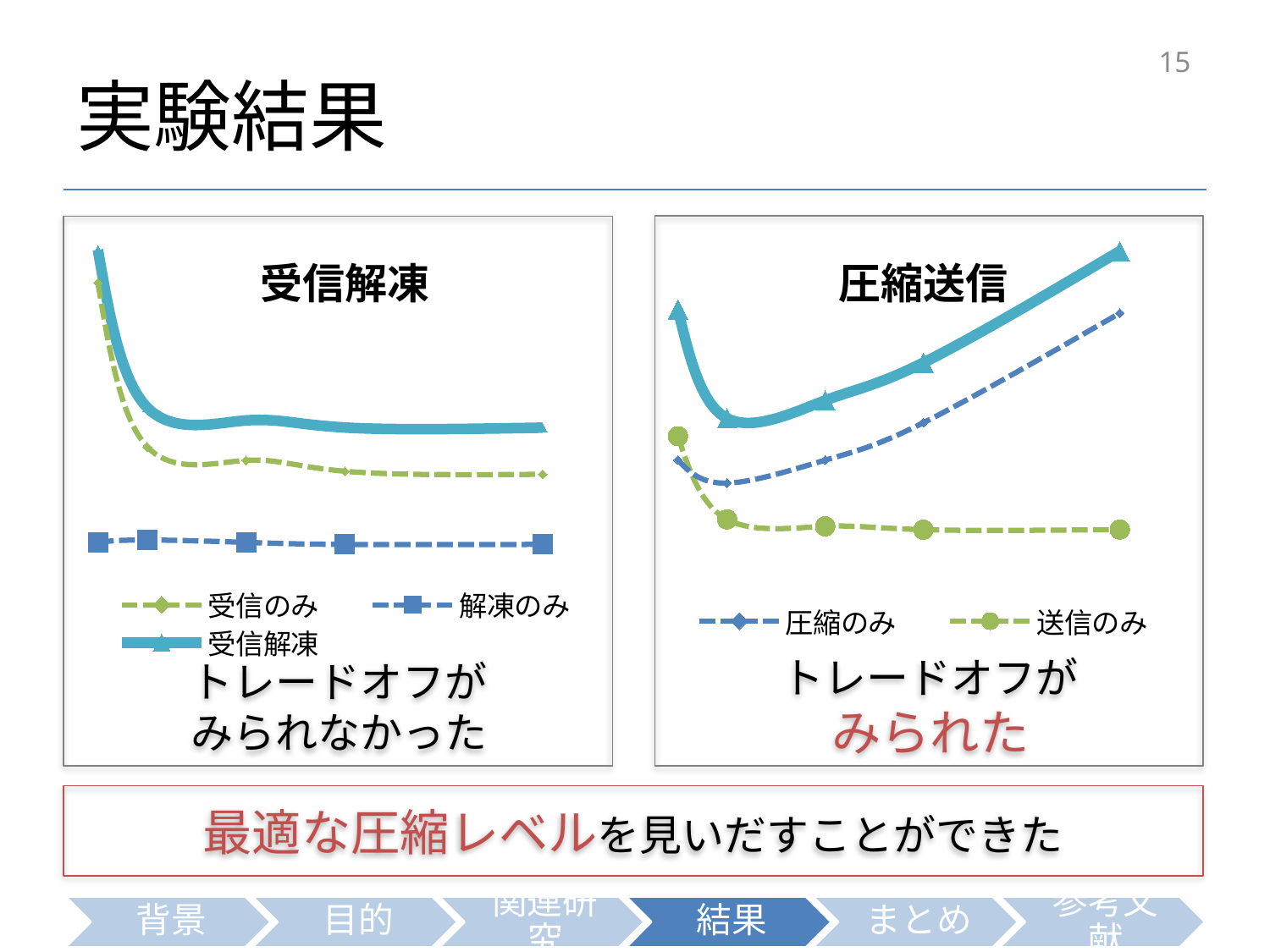
How many series does the legend of the 圧縮送信 chart list? 2 In the 受信解凍 chart, do the values of the 受信のみ series rise or fall along the x axis? fall In the 圧縮送信 chart, which series is higher at the last point on the x axis, 圧縮のみ or 送信のみ? 圧縮のみ What kind of chart is the chart titled 圧縮送信? line chart In the 圧縮送信 chart, do the values of the 圧縮のみ series rise or fall from the second point to the last point? rise In the 受信解凍 chart, which series has the lowest values across the x axis? 解凍のみ In the 圧縮送信 chart, do the values of the 送信のみ series rise or fall along the x axis? fall How many series does the legend of the 受信解凍 chart list? 3 What kind of chart is the chart titled 受信解凍? line chart How many data points are plotted for the 送信のみ series in the 圧縮送信 chart? 5 In the 受信解凍 chart, which series has the highest values across the x axis? 受信解凍 What is the title of the chart on the left side of the slide? 受信解凍